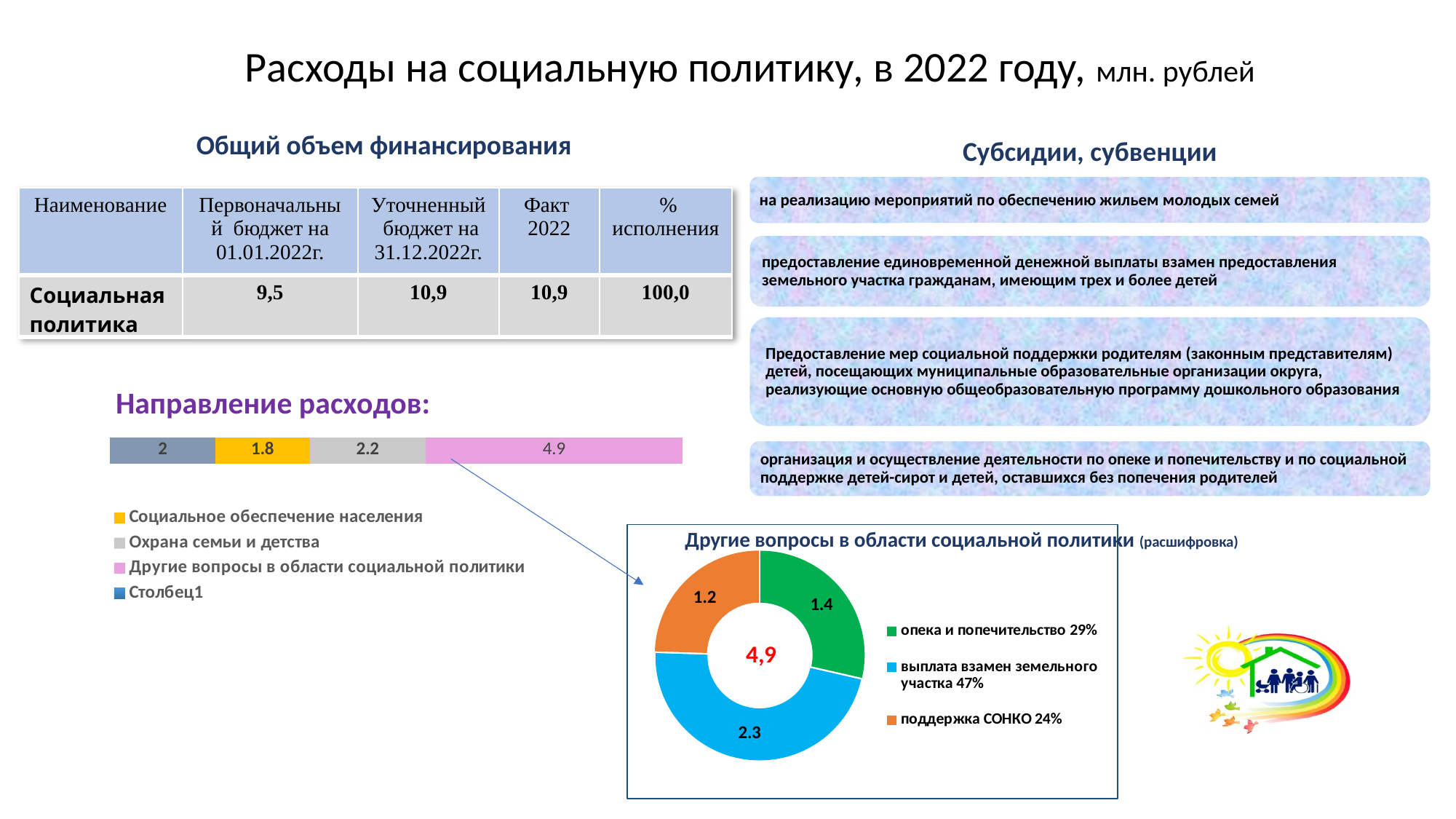
In the 'Направление расходов' chart, what is the value for 'Другие вопросы в области социальной политики'? 4.9 In the 'Направление расходов' chart, how many series does the legend list? 4 In the 'Направление расходов' chart, what is the value for 'Социальное обеспечение населения'? 1.8 In the 'Направление расходов' chart, what is the difference between 'Другие вопросы в области социальной политики' and 'Охрана семьи и детства'? 2.7 In the 'Другие вопросы в области социальной политики' chart, what is the value for 'выплата взамен земельного участка'? 2.3 In the 'Другие вопросы в области социальной политики' chart, what is the value for 'поддержка СОНКО'? 1.2 In the 'Другие вопросы в области социальной политики' chart, what share does 'опека и попечительство' have? 29% What kind of chart is the 'Другие вопросы в области социальной политики' chart? Doughnut chart In the 'Другие вопросы в области социальной политики' chart, which category has the smallest value? поддержка СОНКО In the 'Направление расходов' chart, which series has the largest value? Другие вопросы в области социальной политики In the 'Направление расходов' chart, what is the value for 'Охрана семьи и детства'? 2.2 What kind of chart is the 'Направление расходов' chart? Stacked bar chart